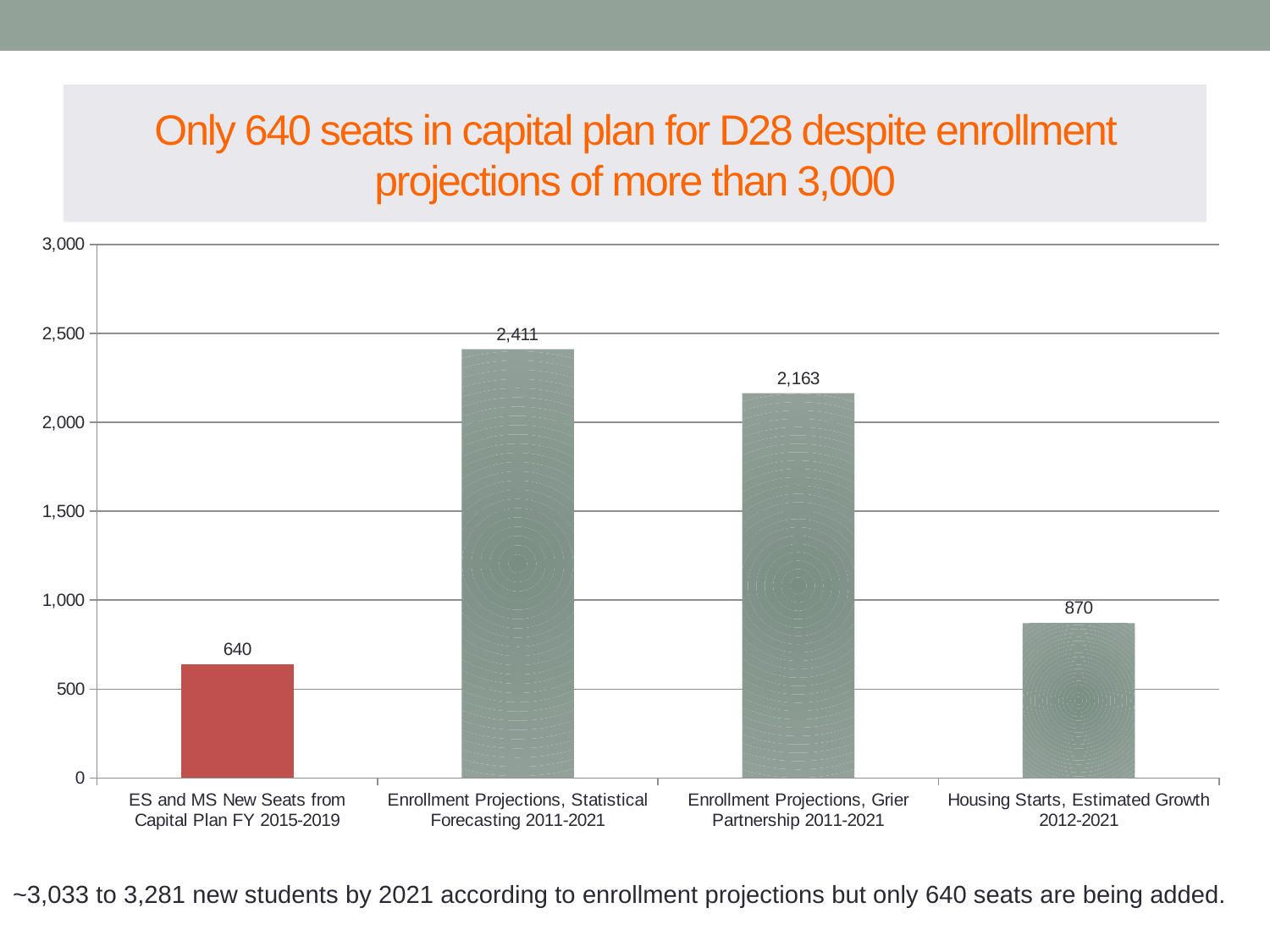
Which category has the highest value? Enrollment Projections, Statistical Forecasting 2011-2021 What is the value for Housing Starts, Estimated Growth 2012-2021? 870 Which category has the lowest value? ES and MS New Seats from Capital Plan FY 2015-2019 What is the difference between Housing Starts, Estimated Growth 2012-2021 and ES and MS New Seats from Capital Plan FY 2015-2019? 230 What is the value for Enrollment Projections, Statistical Forecasting 2011-2021? 2,411 Which is larger: Housing Starts, Estimated Growth 2012-2021 or ES and MS New Seats from Capital Plan FY 2015-2019? Housing Starts, Estimated Growth 2012-2021 How many categories are shown in the chart? 4 What is the value for ES and MS New Seats from Capital Plan FY 2015-2019? 640 What is the value for Enrollment Projections, Grier Partnership 2011-2021? 2,163 What is the difference between the Statistical Forecasting projection and the Grier Partnership projection? 248 What kind of chart is shown on the slide? Bar chart Is the value for Enrollment Projections, Grier Partnership 2011-2021 greater or less than 2,000? greater